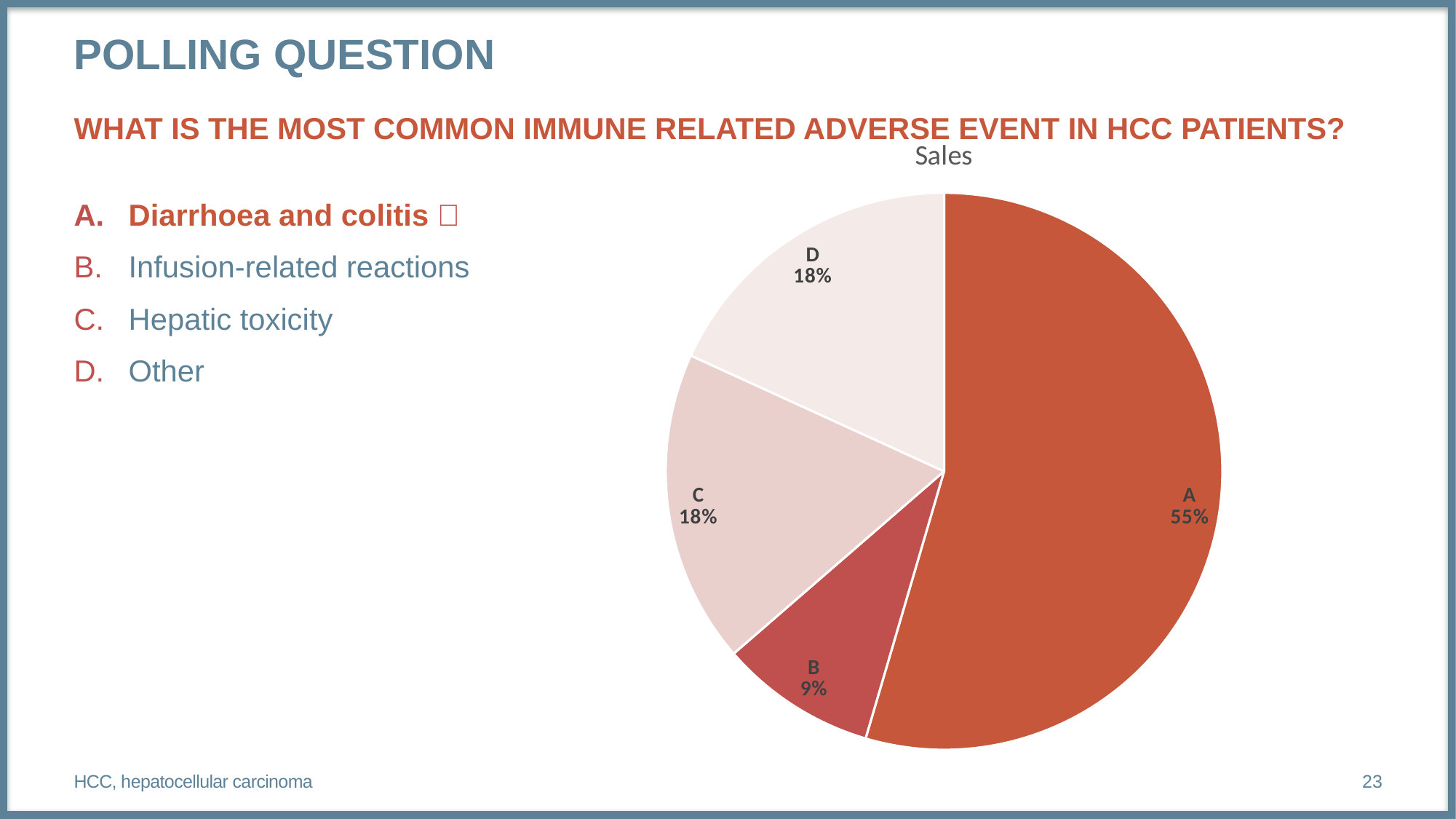
What share of the pie does slice B have? 9% Which slice is the largest in the pie chart? A What is the difference in percentage points between slice A and slice B? 46 What is the difference in percentage points between slice C and slice B? 9 What share of the pie does slice A have? 55% What share of the pie does slice D have? 18% What is the title of the chart? Sales Which is larger, slice A or slice C? A What type of chart is shown on the slide? pie chart Which slice is the smallest in the pie chart? B How many slices does the pie chart have? 4